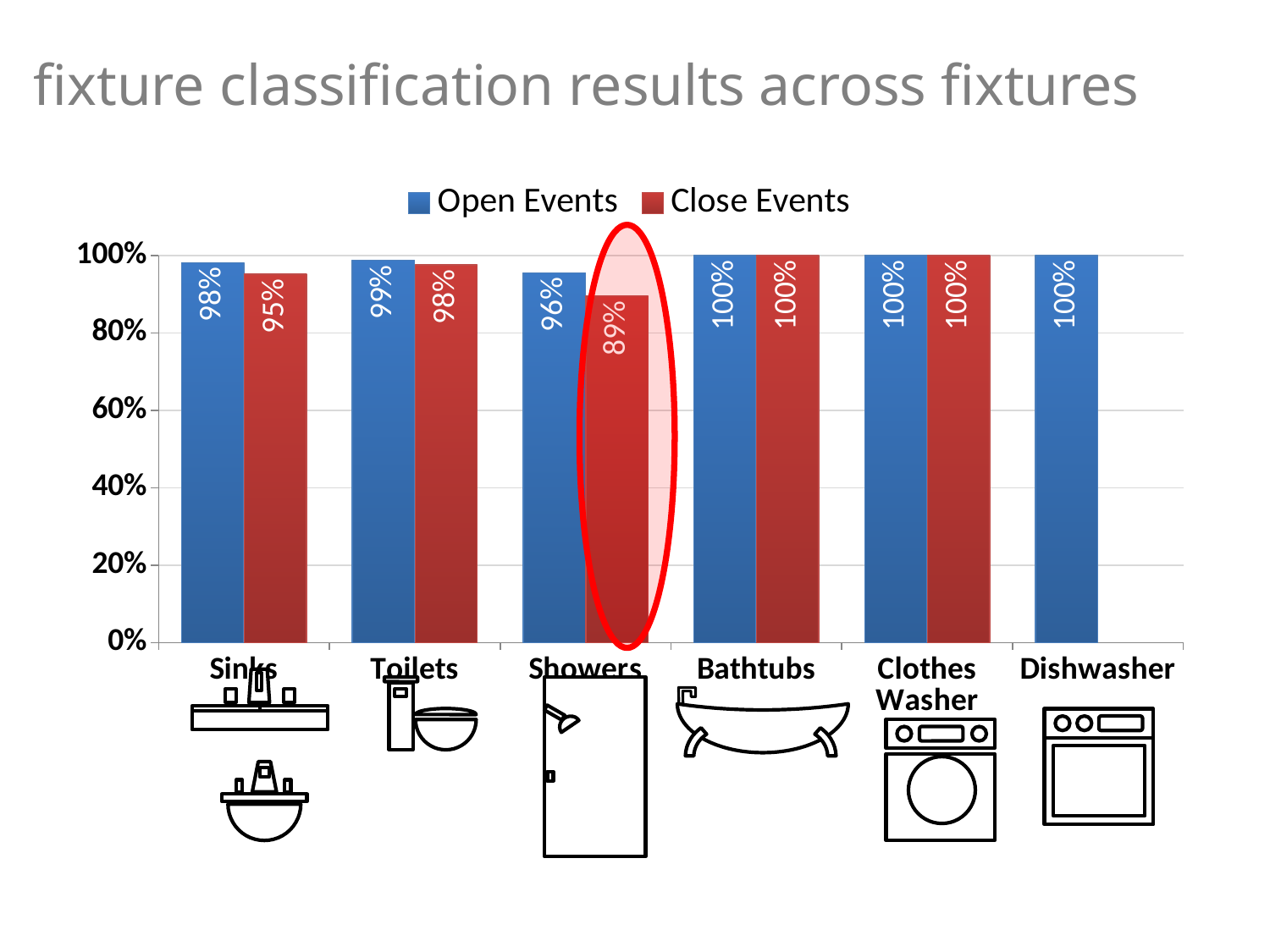
What kind of chart is shown on the slide? Bar chart What is the Open Events value for Sinks? 98% Which fixture has the lowest Close Events value? Showers What is the Close Events value for Toilets? 98% What is the Open Events value for Dishwasher? 100% Which fixture has the lowest Open Events value? Showers What is the difference between the Open Events and Close Events values for Sinks? 3% What is the difference between the Open Events and Close Events values for Showers? 7% What is the Close Events value for Showers? 89% How many series does the legend list? 2 Which is larger, the Close Events value for Sinks or the Close Events value for Toilets? Toilets How many fixture categories are shown on the x axis? 6